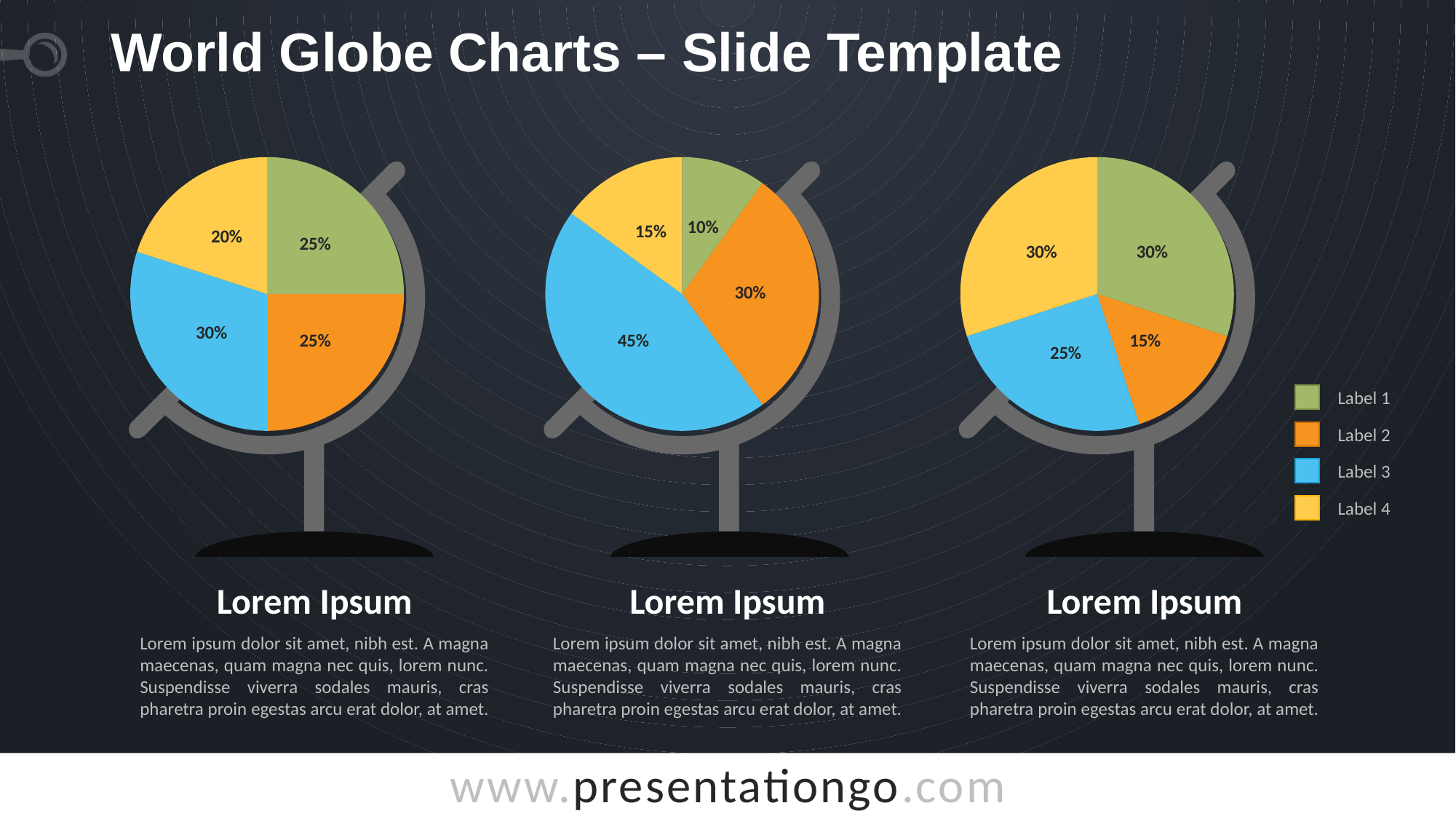
In the left pie chart, which label has the smallest share? Label 4 In the middle pie chart, what is the value for Label 1? 10% How many entries does the legend list? 4 How many slices does the middle pie chart have? 4 In the right pie chart, which label has the smallest share? Label 2 In the right pie chart, what is the value for Label 2? 15% In the left pie chart, which is larger, Label 3 or Label 1? Label 3 In the right pie chart, which is larger, Label 3 or Label 4? Label 4 In the left pie chart, what is the value for Label 3? 30% In the middle pie chart, which label has the largest share? Label 3 In the middle pie chart, what is the difference between the values for Label 3 and Label 2? 15% What kind of chart is the left chart? Pie chart